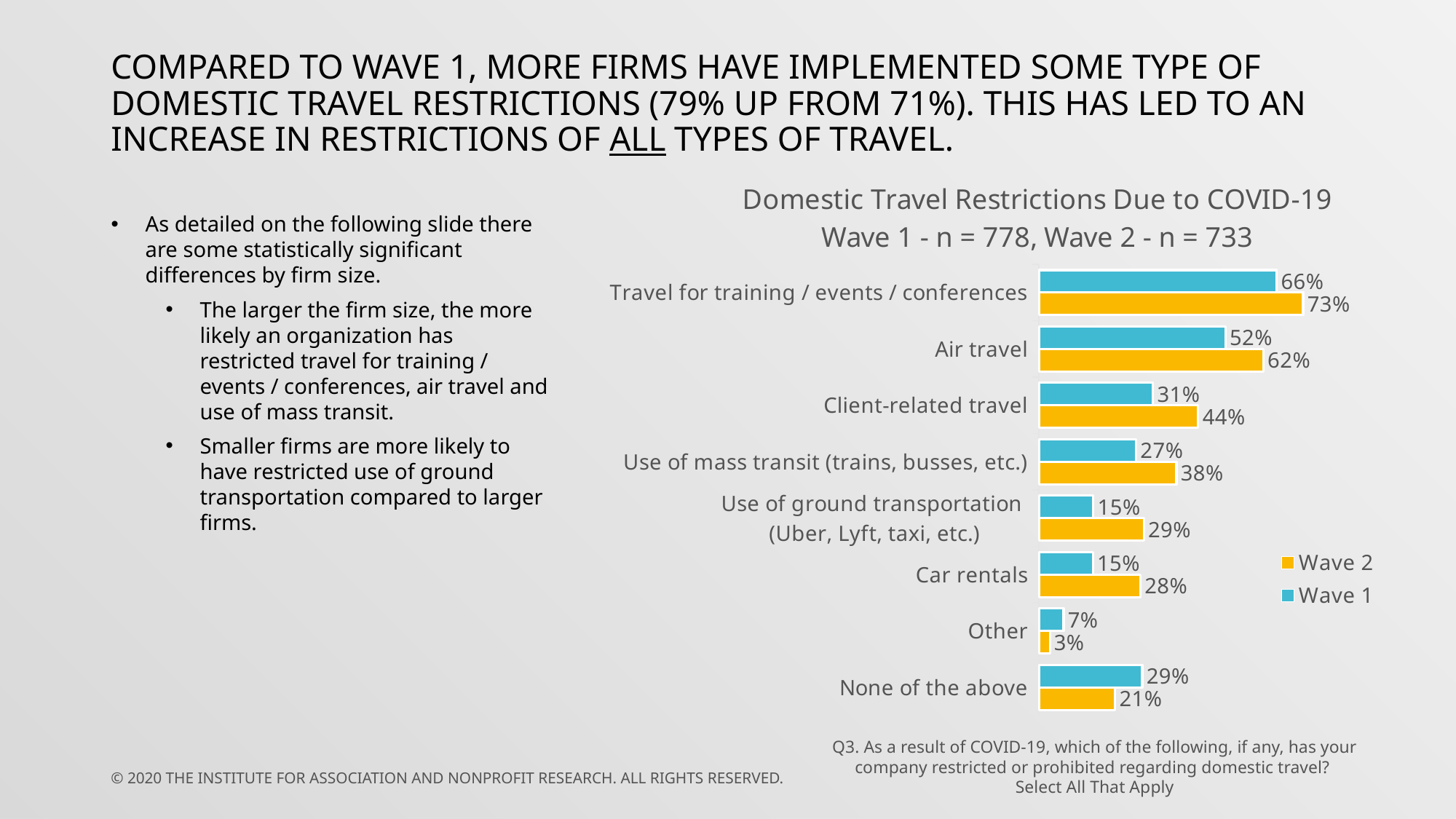
Which category has the highest Wave 2 value? Travel for training / events / conferences What is the Wave 2 value for Car rentals? 28% What is the difference between the Wave 2 and Wave 1 values for Use of ground transportation (Uber, Lyft, taxi, etc.)? 14% What is the Wave 1 value for Client-related travel? 31% What is the Wave 2 value for Air travel? 62% How many series does the legend list? 2 What is the title of the chart? Domestic Travel Restrictions Due to COVID-19 Wave 1 - n = 778, Wave 2 - n = 733 Which is larger for None of the above: the Wave 1 value or the Wave 2 value? Wave 1 Which colour represents Wave 2 in the chart? Yellow How many categories are shown on the chart? 8 What kind of chart is shown on the slide? Bar chart Which category has the lowest Wave 1 value? Other